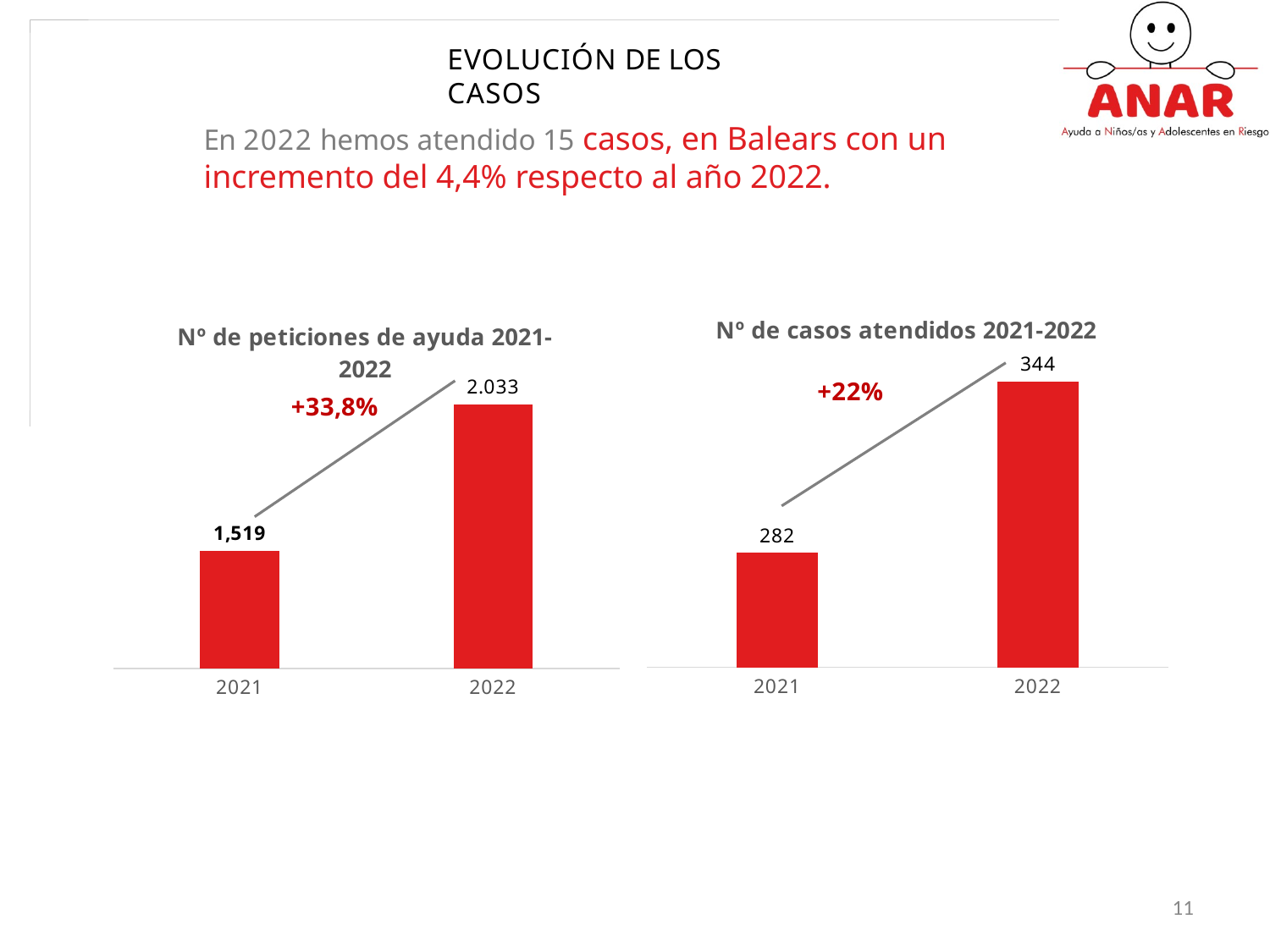
In the chart 'Nº de peticiones de ayuda 2021-2022', which year has the lower value? 2021 What type of chart is 'Nº de casos atendidos 2021-2022'? Bar chart In the chart 'Nº de casos atendidos 2021-2022', what is the value for 2021? 282 In the chart 'Nº de peticiones de ayuda 2021-2022', what is the value for 2021? 1,519 In the chart 'Nº de casos atendidos 2021-2022', do the values rise or fall from 2021 to 2022? Rise In the chart 'Nº de peticiones de ayuda 2021-2022', by how much does the 2022 value exceed the 2021 value? 514 How many bars are shown in the chart 'Nº de peticiones de ayuda 2021-2022'? 2 In the chart 'Nº de peticiones de ayuda 2021-2022', what is the value for 2022? 2.033 In the chart 'Nº de casos atendidos 2021-2022', what is the value for 2022? 344 What percentage increase is annotated on the chart 'Nº de peticiones de ayuda 2021-2022'? +33,8% In the chart 'Nº de casos atendidos 2021-2022', what is the difference between the 2022 and 2021 values? 62 In the chart 'Nº de casos atendidos 2021-2022', which year has the higher value? 2022